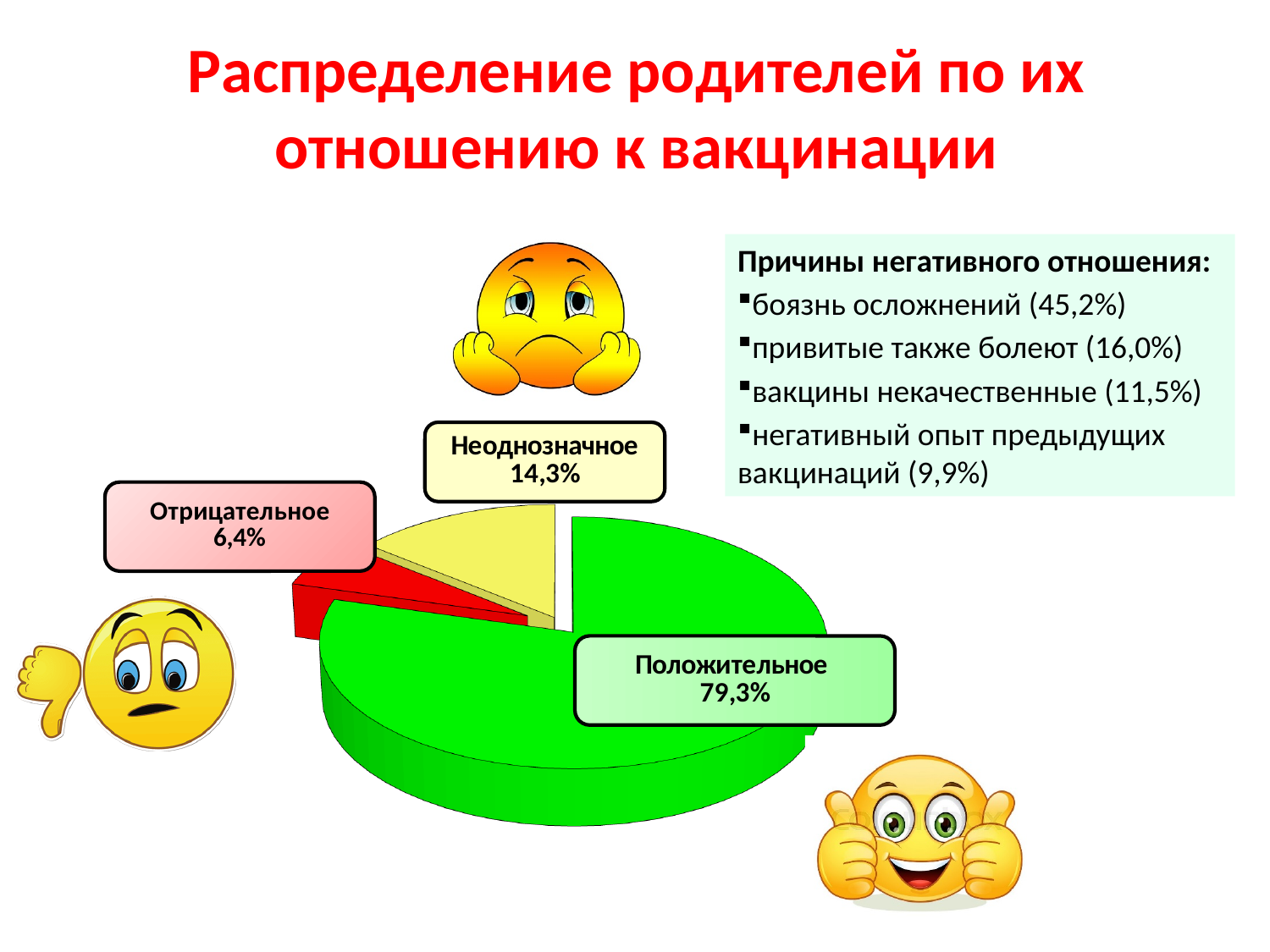
Which category has the smallest slice of the pie? Отрицательное What share of parents have a positive attitude (Положительное) to vaccination? 79,3% What is the difference between the share for Положительное and the share for Неоднозначное? 65,0% How many categories are shown in the pie chart? 3 Which category has the largest slice of the pie? Положительное What is the title of the slide containing the pie chart? Распределение родителей по их отношению к вакцинации What share of parents have an ambiguous attitude (Неоднозначное) to vaccination? 14,3% What colour is the slice for Положительное? Green Which is larger, the share for Неоднозначное or the share for Отрицательное? Неоднозначное What share of parents have a negative attitude (Отрицательное) to vaccination? 6,4% What kind of chart is shown on the slide? Pie chart What is the difference between the share for Неоднозначное and the share for Отрицательное? 7,9%